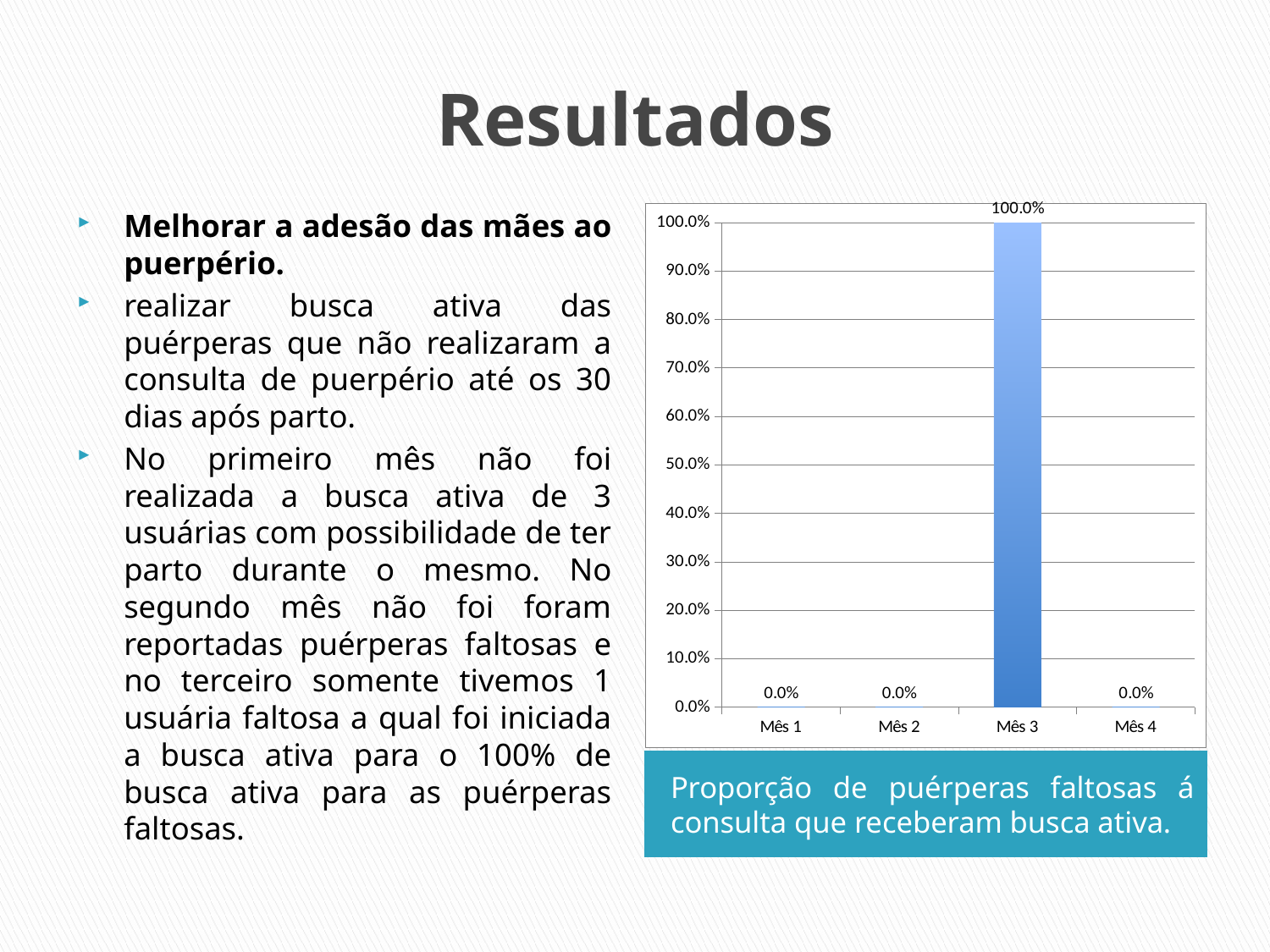
What is the value for Mês 1? 0.0% What is the value for Mês 3? 100.0% What is the value for Mês 4? 0.0% What kind of chart is shown on the slide? bar chart How many months are shown on the x axis of the chart? 4 What is the caption below the chart? Proporção de puérperas faltosas á consulta que receberam busca ativa. What is the value for Mês 2? 0.0% Is the value for Mês 3 greater or less than 50.0%? greater Which is larger, the value for Mês 3 or the value for Mês 4? Mês 3 What is the highest value shown on the y axis of the chart? 100.0% What is the difference between the values for Mês 3 and Mês 2? 100.0% Which month has the highest value? Mês 3